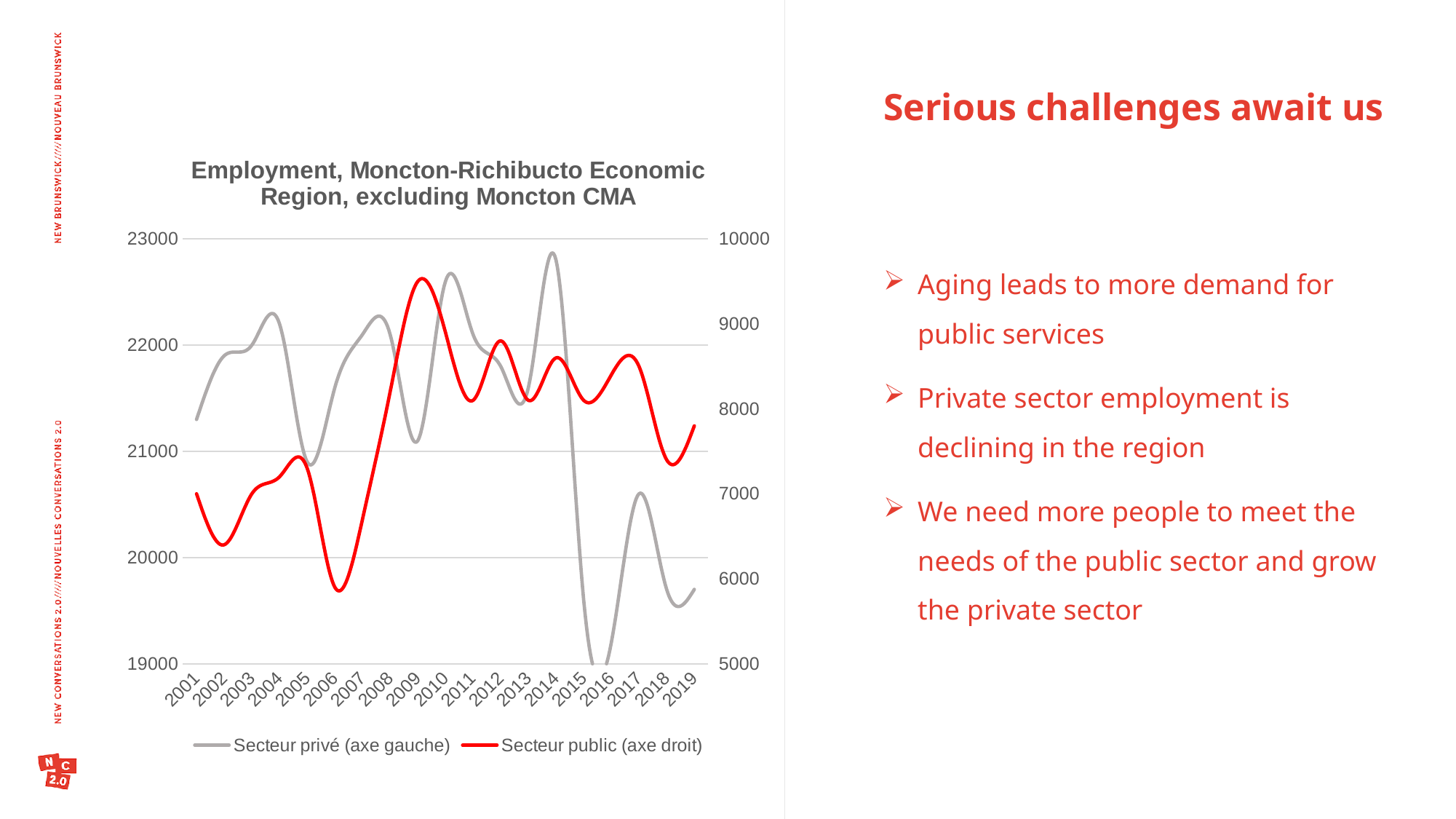
What is the title of the chart? Employment, Moncton-Richibucto Economic Region, excluding Moncton CMA How many series does the chart's legend list? 2 Does the Secteur privé series rise or fall between 2014 and 2016? fall What kind of chart is shown on the slide? Line chart Which series is plotted against the right axis according to the legend? Secteur public (axe droit) In which year does the Secteur public series reach its lowest value? 2006 In which year does the Secteur public series reach its highest value? 2009 How many years are shown along the x axis of the chart? 19 Is the Secteur privé value for 2016 greater or less than 20000? less In which year does the Secteur privé series reach its highest value? 2014 Is the Secteur public value for 2009 greater or less than 9000? greater In which year does the Secteur privé series reach its lowest value? 2016